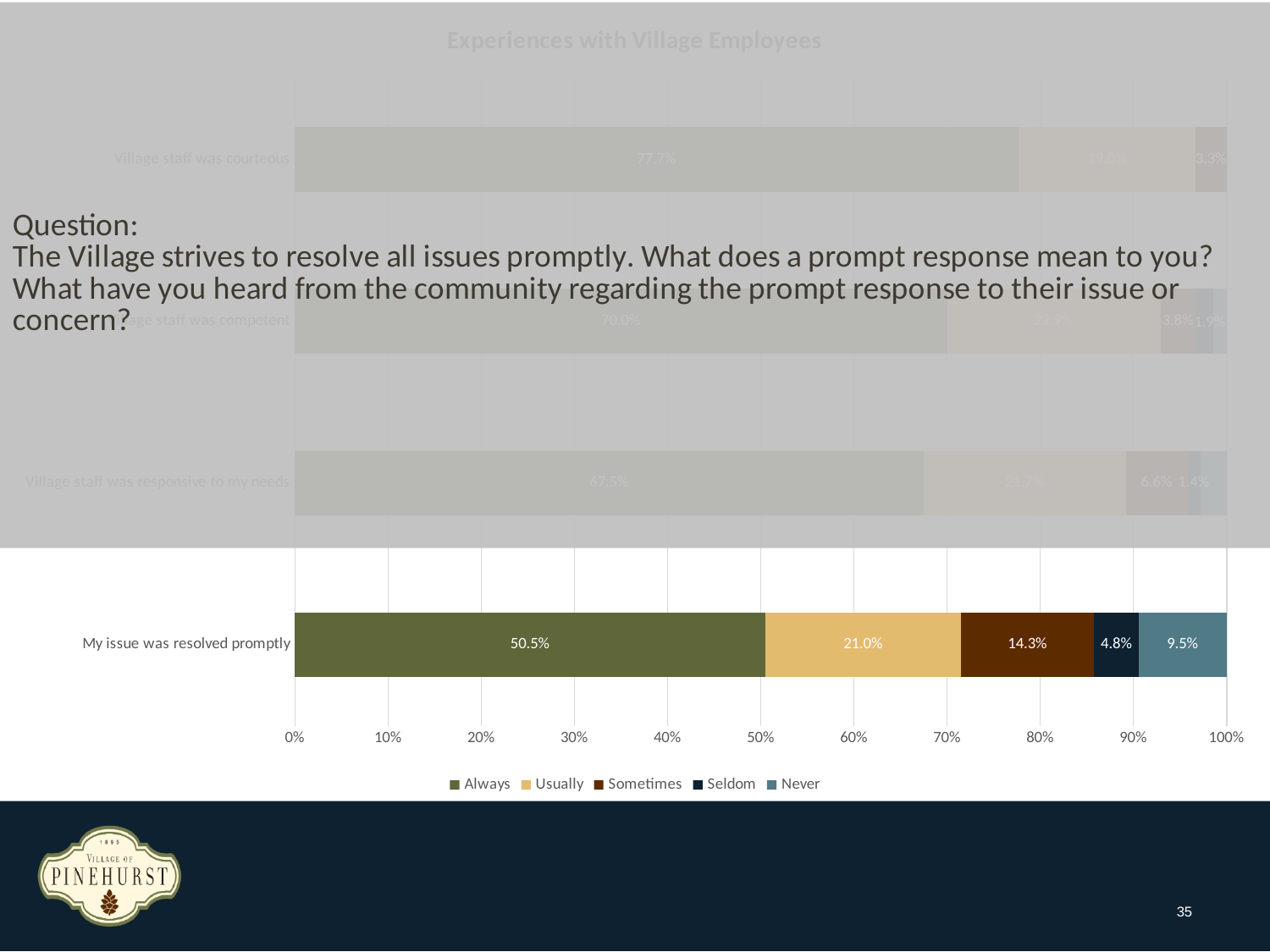
What share of respondents said 'Sometimes' for 'My issue was resolved promptly'? 14.3% For 'My issue was resolved promptly', which is larger: the 'Never' share or the 'Seldom' share? Never What is the title of the chart? Experiences with Village Employees What percentage of respondents answered 'Always' for 'My issue was resolved promptly'? 50.5% What percentage answered 'Never' for 'My issue was resolved promptly'? 9.5% How many series does the legend list? 5 What is the 'Seldom' value for 'My issue was resolved promptly'? 4.8% Which response category has the smallest share for 'My issue was resolved promptly'? Seldom For 'My issue was resolved promptly', how much larger is the 'Always' share than the 'Usually' share? 29.5% Which response category has the largest share for 'My issue was resolved promptly'? Always What kind of chart is shown on the slide? Stacked bar chart What is the 'Usually' value for 'My issue was resolved promptly'? 21.0%